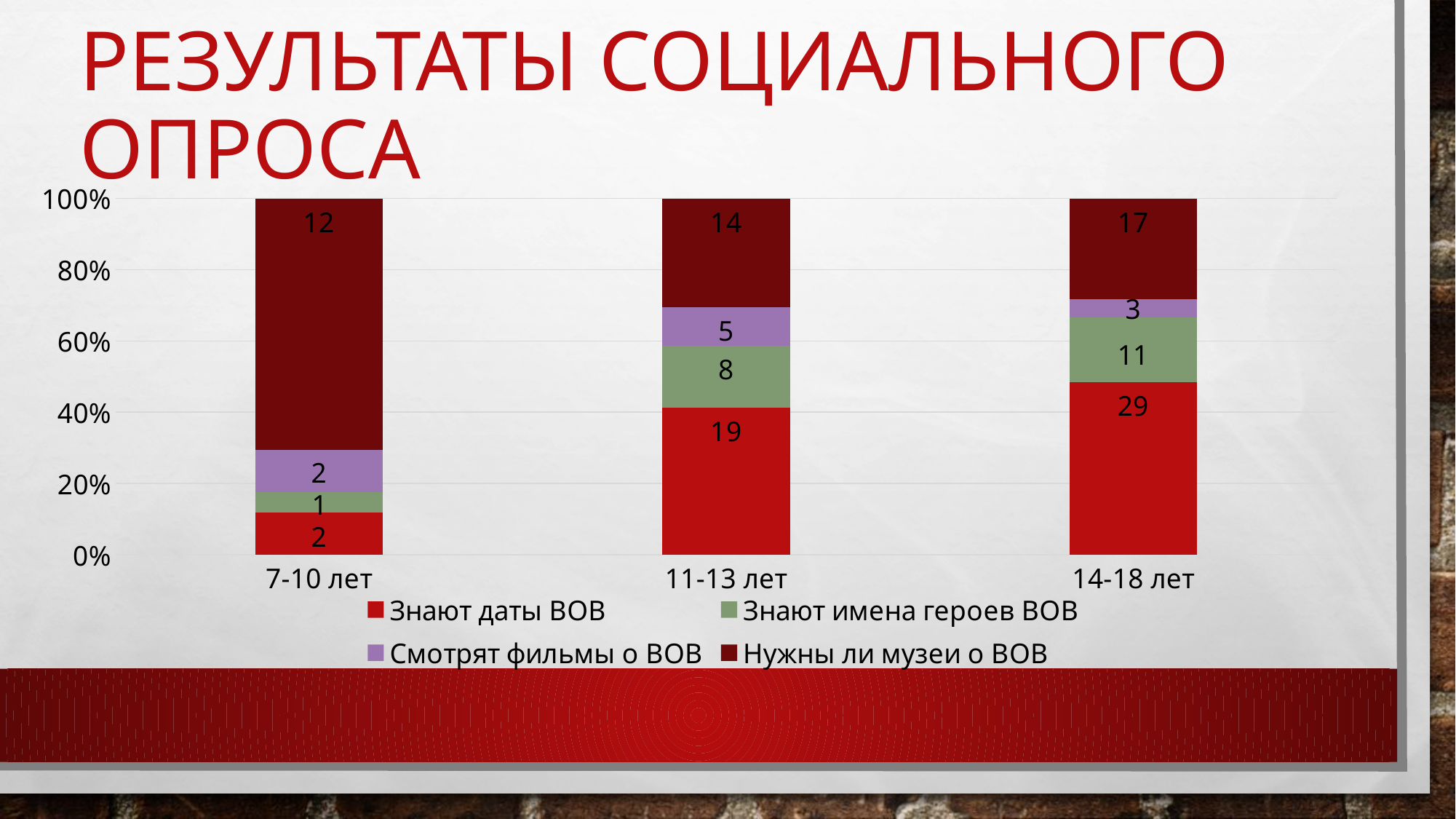
Which age group has the lowest value for "Знают имена героев ВОВ"? 7-10 лет What is the difference between the "Знают даты ВОВ" values for 14-18 лет and 11-13 лет? 10 How many age groups are shown on the x axis? 3 What is the value of "Смотрят фильмы о ВОВ" for the 11-13 лет group? 5 What is the total of all four values in the 11-13 лет bar? 46 What is the value of "Нужны ли музеи о ВОВ" for the 7-10 лет group? 12 Which is larger: "Нужны ли музеи о ВОВ" for 11-13 лет or for 14-18 лет? 14-18 лет Which age group has the highest value for "Знают даты ВОВ"? 14-18 лет What kind of chart is shown on the slide? Stacked bar chart What is the value of "Знают имена героев ВОВ" for the 14-18 лет group? 11 How many series does the legend list? 4 What is the value of "Знают даты ВОВ" for the 14-18 лет group? 29